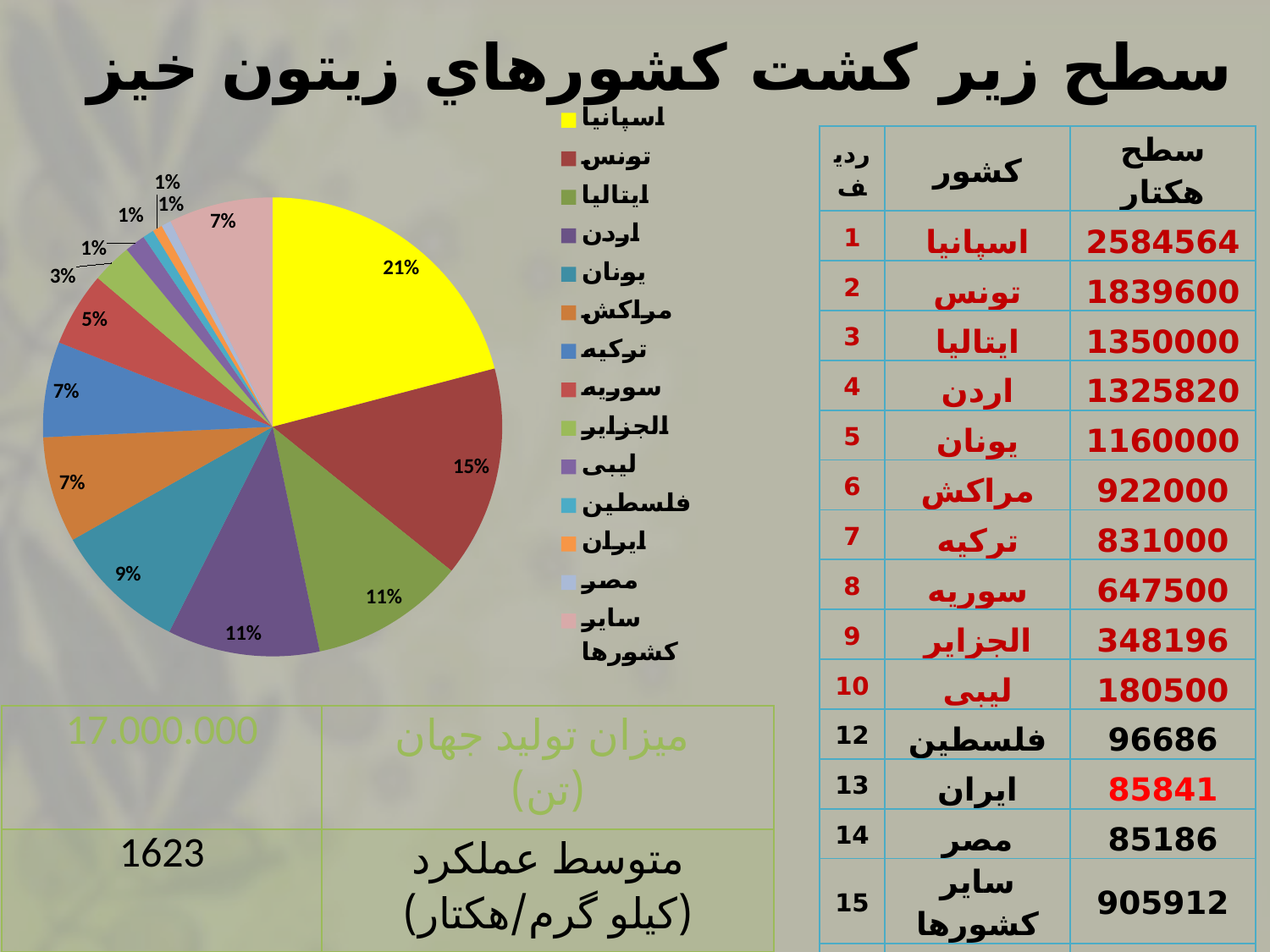
What percentage of the pie chart does الجزایر (Algeria) account for? 3% What percentage of the pie chart does اسپانیا (Spain) account for? 21% What colour is the slice for اسپانیا (Spain) in the pie chart? yellow What percentage of the pie chart does یونان (Greece) account for? 9% What percentage of the pie chart does سوریه (Syria) account for? 5% How many entries does the legend of the pie chart list? 14 What is the difference in percentage points between the slices for اسپانیا (Spain) and تونس (Tunisia)? 6 What is the title of the slide containing the pie chart? سطح زیر کشت کشورهای زیتون خیز Which country has the largest slice of the pie chart? اسپانیا What percentage of the pie chart does تونس (Tunisia) account for? 15% What kind of chart is shown on the slide? pie chart Which slice is larger in the pie chart, تونس (Tunisia) or ایتالیا (Italy)? تونس